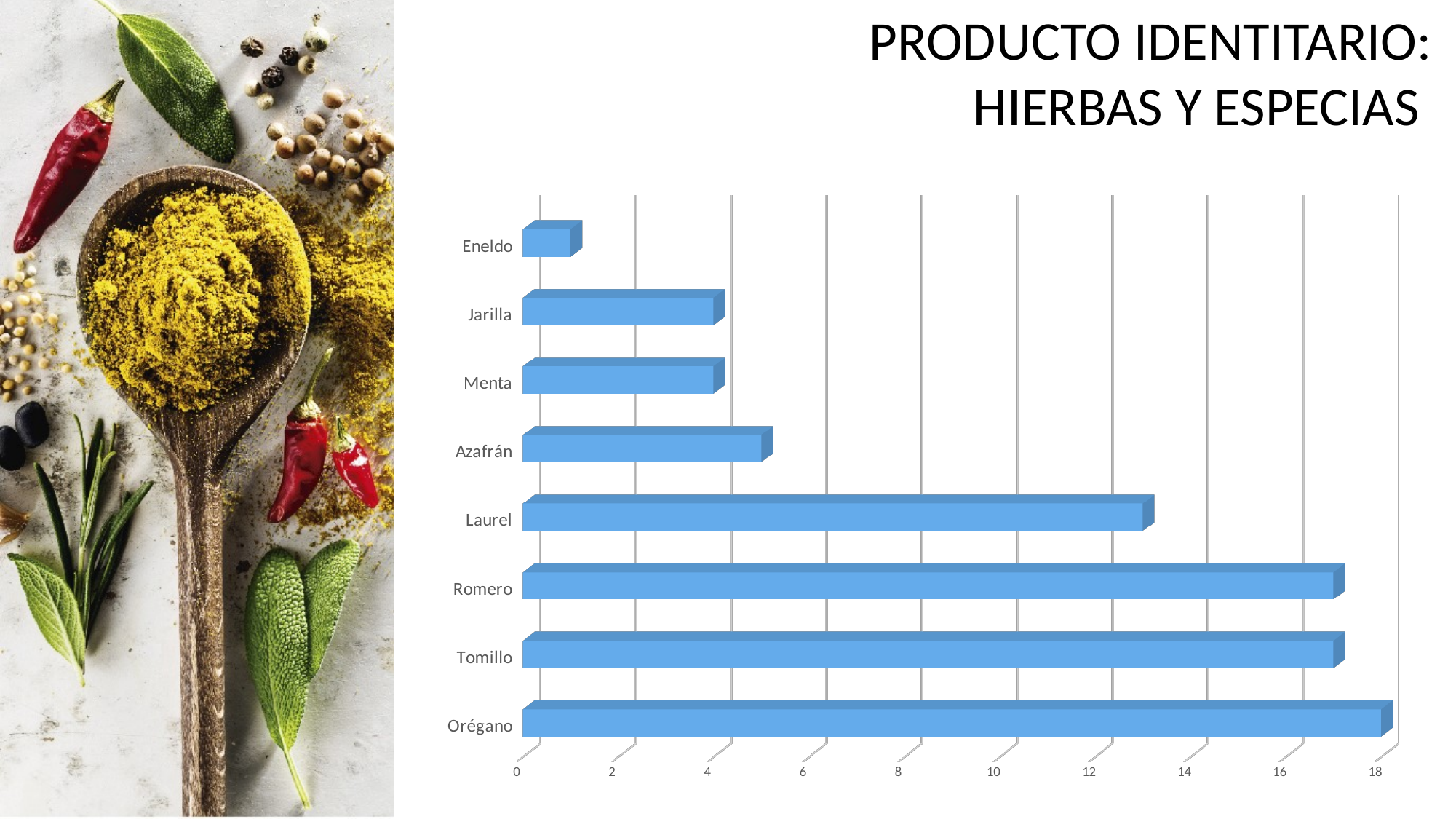
What kind of chart is shown on the slide? bar chart Is the value for Eneldo greater or less than 2? less Which category has the highest value in the chart? Orégano Is the value for Laurel greater or less than 12? greater How many categories (herbs and spices) are plotted in the chart? 8 Which has a larger value, Eneldo or Orégano? Orégano What is the title shown above the chart on the slide? PRODUCTO IDENTITARIO: HIERBAS Y ESPECIAS Which has a larger value, Laurel or Azafrán? Laurel Which category has the lowest value in the chart? Eneldo Is the value for Laurel greater or less than 14? less